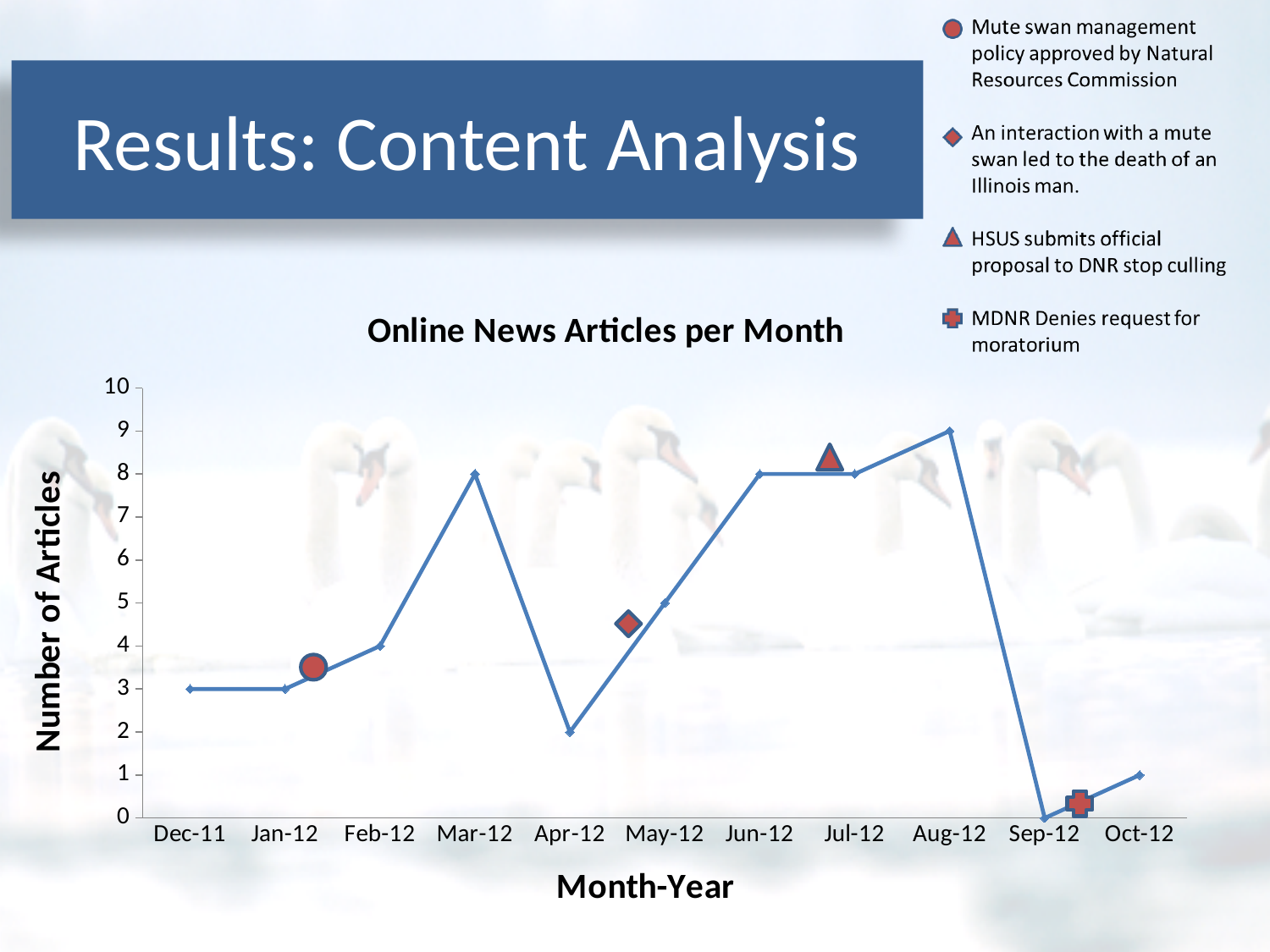
Which month has the lowest number of articles? Sep-12 What is the difference in number of articles between Aug-12 and Sep-12? 9 Which has more articles, Feb-12 or May-12? May-12 Do the number of articles rise or fall from Apr-12 to Jun-12? rise What kind of chart is shown on the slide? line chart Which month has the highest number of articles? Aug-12 How many months are plotted on the x axis of the chart? 11 What is the label of the y axis? Number of Articles What is the number of articles for Apr-12? 2 What is the number of articles for Mar-12? 8 What is the title of the chart? Online News Articles per Month What is the number of articles for Sep-12? 0